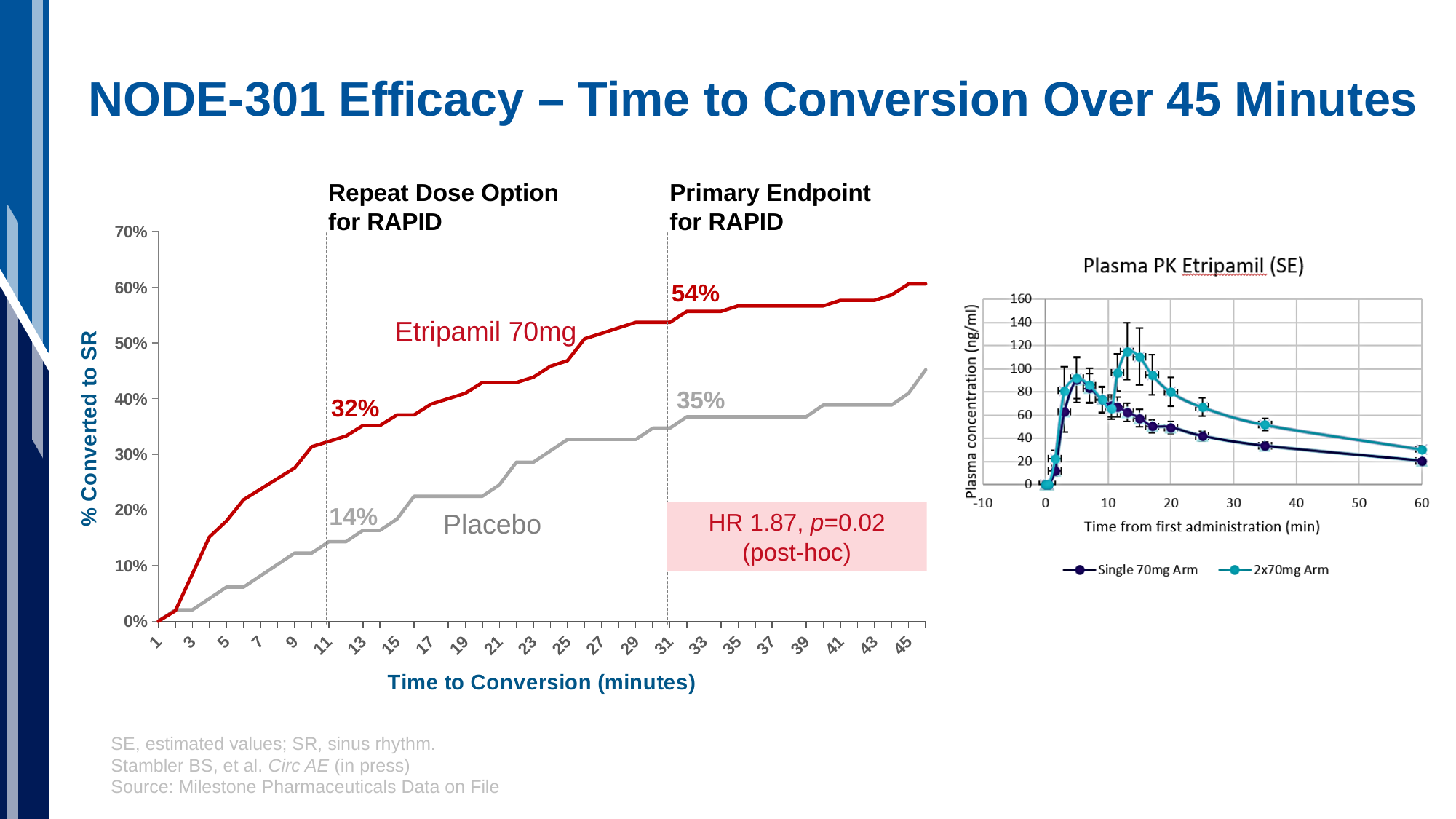
On the Time to Conversion chart, what percentage of Placebo patients had converted to SR at the Primary Endpoint line (31 minutes)? 35% On the Plasma PK Etripamil (SE) chart, which arm has the higher plasma concentration at 60 minutes, Single 70mg Arm or 2x70mg Arm? 2x70mg Arm On the Time to Conversion chart, what is the difference between the Etripamil 70mg and Placebo conversion rates at the Repeat Dose Option line (11 minutes)? 18% On the Time to Conversion chart, is the Placebo conversion rate at 45 minutes greater or less than 50%? less On the Time to Conversion chart, what is the difference between the Etripamil 70mg and Placebo conversion rates at the Primary Endpoint (31 minutes)? 19% On the Time to Conversion chart, what percentage of Etripamil 70mg patients had converted to SR at the Primary Endpoint line (31 minutes)? 54% On the Time to Conversion chart, which group has the higher conversion rate at 31 minutes, Etripamil 70mg or Placebo? Etripamil 70mg On the Time to Conversion chart, what percentage of Etripamil 70mg patients had converted to SR at the Repeat Dose Option line (11 minutes)? 32% On the Time to Conversion chart, do the conversion rates rise or fall as time increases along the x axis? rise How many series does the legend of the Plasma PK Etripamil (SE) chart list? 2 On the Time to Conversion chart, what percentage of Placebo patients had converted to SR at the Repeat Dose Option line (11 minutes)? 14%